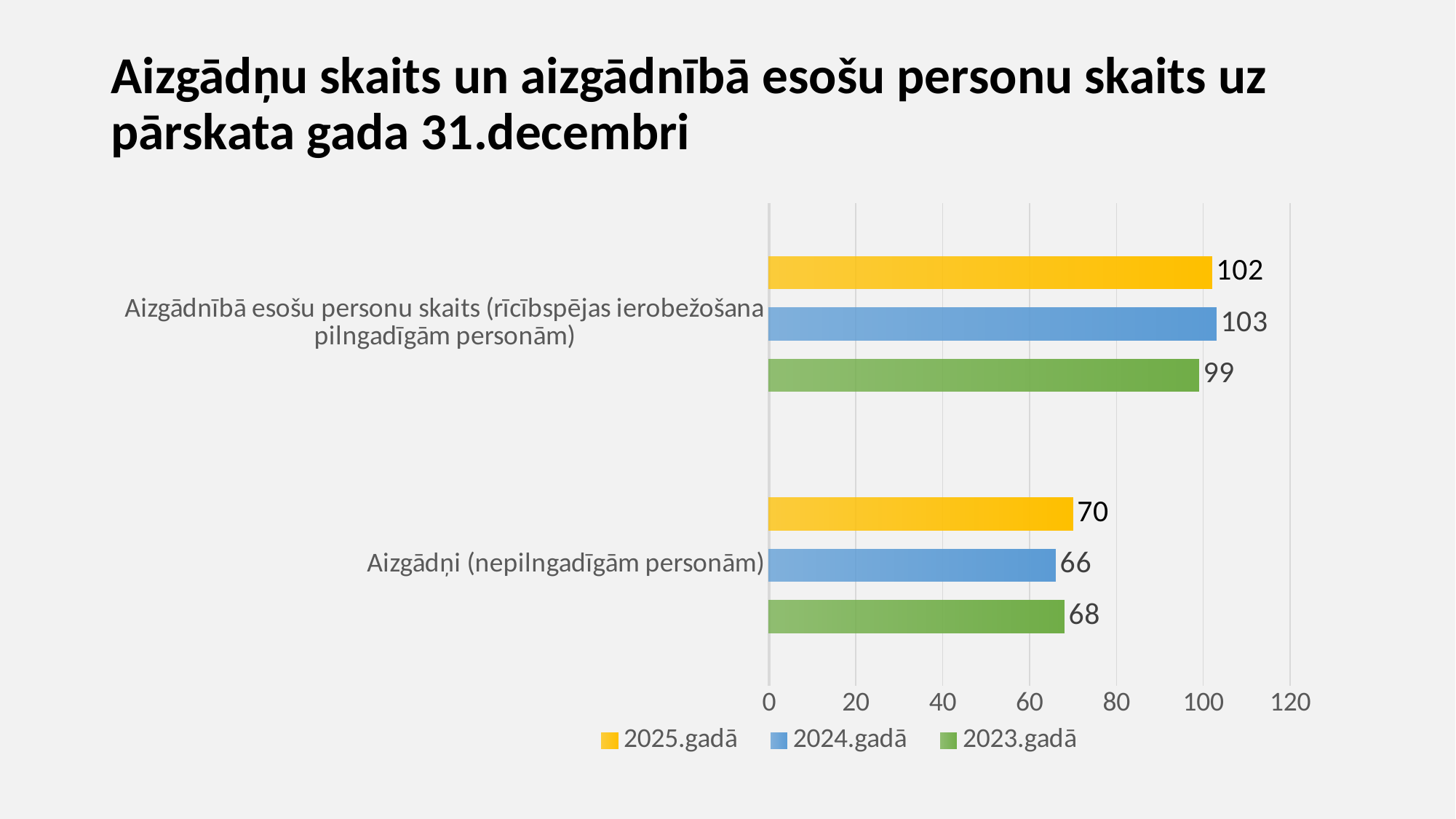
What is the difference between the 2024.gadā and 2023.gadā values for 'Aizgādnībā esošu personu skaits (rīcībspējas ierobežošana pilngadīgām personām)'? 4 Is the 2025.gadā value for 'Aizgādņi (nepilngadīgām personām)' greater or less than 80? less Which year has the lowest value in the category 'Aizgādnībā esošu personu skaits (rīcībspējas ierobežošana pilngadīgām personām)'? 2023.gadā How many categories are shown on the chart? 2 How many series does the legend list? 3 What is the value for 2025.gadā in the category 'Aizgādnībā esošu personu skaits (rīcībspējas ierobežošana pilngadīgām personām)'? 102 What is the difference between the 2025.gadā and 2023.gadā values for 'Aizgādņi (nepilngadīgām personām)'? 2 What is the value for 2024.gadā in the category 'Aizgādņi (nepilngadīgām personām)'? 66 What kind of chart is shown on the slide? bar chart What is the value for 2023.gadā in the category 'Aizgādnībā esošu personu skaits (rīcībspējas ierobežošana pilngadīgām personām)'? 99 Which year has the highest value in the category 'Aizgādņi (nepilngadīgām personām)'? 2025.gadā Which is larger: the 2024.gadā value for 'Aizgādņi (nepilngadīgām personām)' or the 2023.gadā value for the same category? 2023.gadā